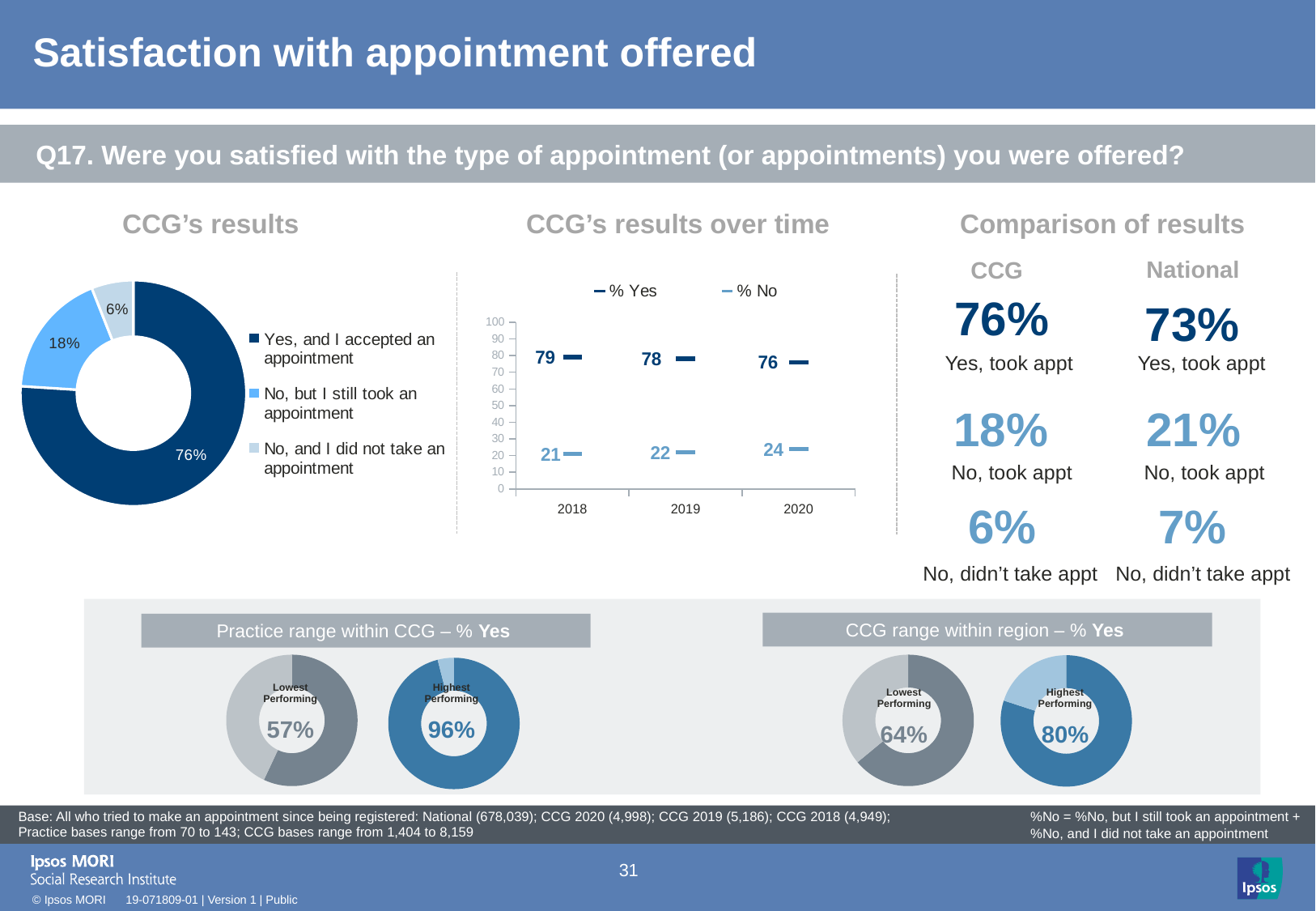
In the 'CCG's results over time' chart, how many series does the legend list? 2 What type of chart is used for 'CCG's results'? Donut (pie) chart In the 'CCG's results' donut chart, what percentage is shown for 'No, and I did not take an appointment'? 6% In the 'CCG's results' donut chart, what percentage is shown for 'Yes, and I accepted an appointment'? 76% In the 'CCG's results over time' chart, what is the % Yes value for 2019? 78 How many categories does the 'CCG's results' donut chart show? 3 In the 'Practice range within CCG – % Yes' charts, what is the Highest Performing value? 96% In the 'CCG's results over time' chart, what is the difference between the % Yes values for 2018 and 2020? 3 In the 'CCG's results over time' chart, what is the % No value for 2020? 24 In the 'CCG range within region – % Yes' charts, what is the difference between the Highest Performing and Lowest Performing values? 16% In the 'CCG's results' donut chart, which category has the largest share? Yes, and I accepted an appointment In the 'CCG's results over time' chart, does the % Yes series rise or fall from 2018 to 2020? Fall